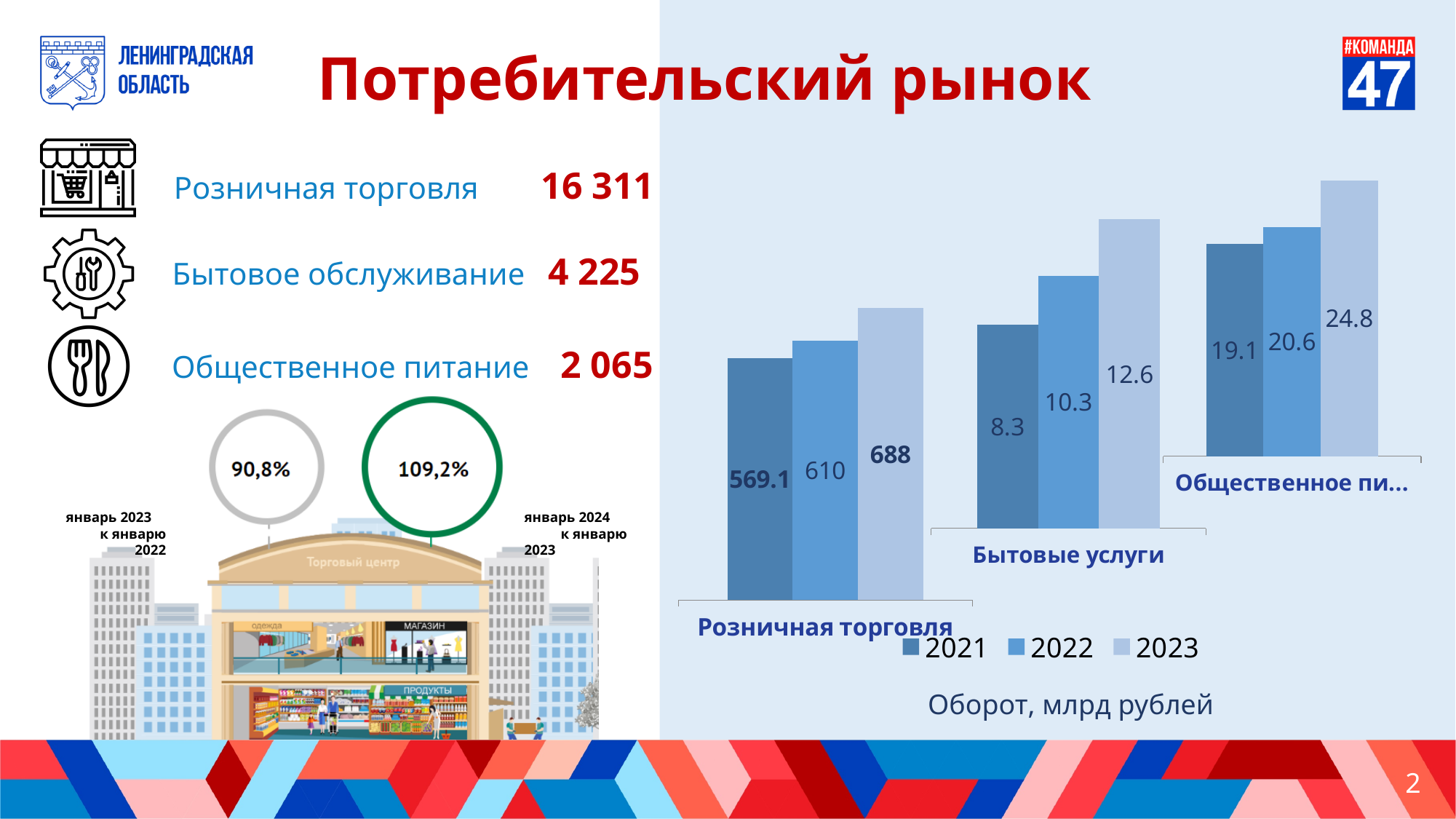
What is the value for Розничная торговля in 2023? 688 What is the value for Бытовые услуги in 2022? 10.3 Which is larger for the Общественное пи... category: the 2021 value or the 2022 value? 2022 What is the 2023 value for the Общественное пи... category? 24.8 What is the difference between the 2023 and 2022 values for Розничная торговля? 78 What kind of chart is shown on the slide? Bar chart Which year has the lowest value for Бытовые услуги? 2021 How many series does the legend list? 3 What is the difference between the 2023 and 2021 values for Бытовые услуги? 4.3 Which year has the highest value for Розничная торговля? 2023 What is the value for Бытовые услуги in 2021? 8.3 What is the value for Розничная торговля in 2021? 569.1